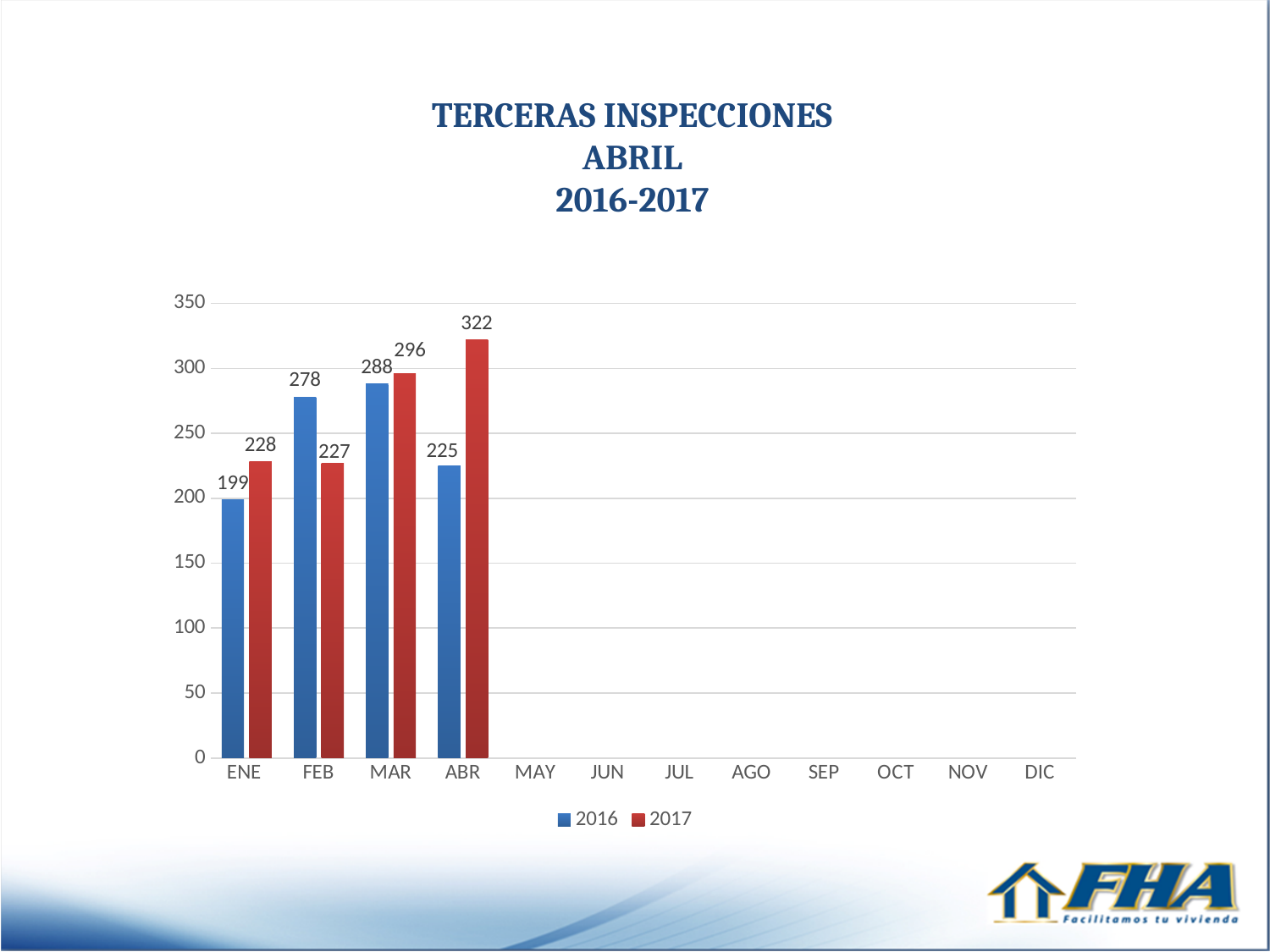
What is the difference between the 2017 and 2016 values in ABR? 97 Which month has the highest value for the 2017 series? ABR What kind of chart is shown on the slide? bar chart How many months have data plotted in the chart? 4 What is the value for 2017 in FEB? 227 What is the value for 2017 in ABR? 322 How many series does the legend list? 2 What is the title of the chart? TERCERAS INSPECCIONES ABRIL 2016-2017 Which is larger in FEB, the 2016 value or the 2017 value? 2016 Which month has the lowest value for the 2016 series? ENE What is the value for 2016 in ENE? 199 Is the value for 2016 in MAR greater or less than 250? greater